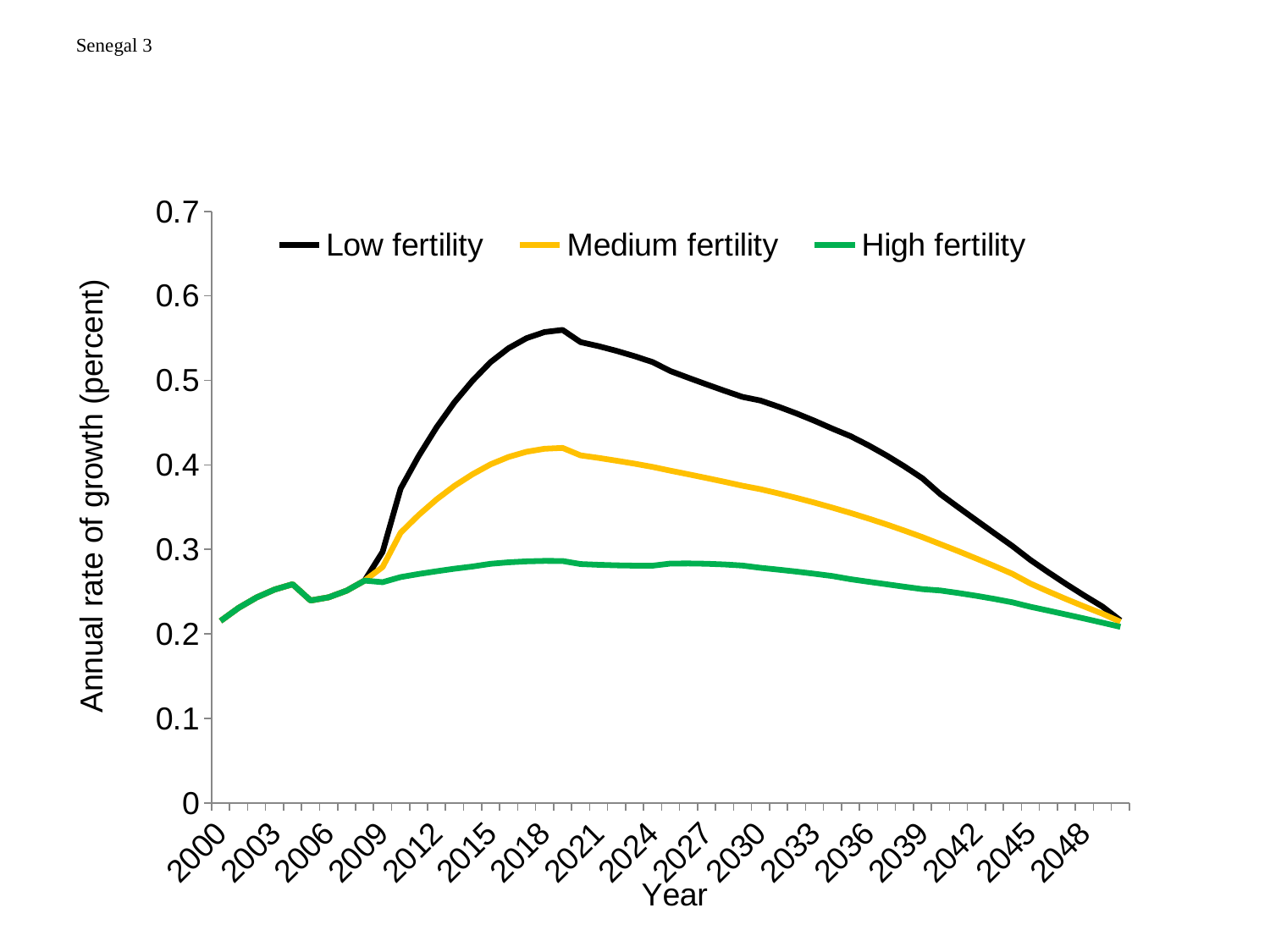
Is the value for High fertility in 2018 greater or less than 0.3? less Is the value for Low fertility in 2018 greater or less than 0.5? greater What is the title of the vertical axis? Annual rate of growth (percent) Is the value for Low fertility in 2048 greater or less than 0.3? less What kind of chart is shown on the slide? Line chart In 2036, which series has the larger value, Medium fertility or High fertility? Medium fertility In 2024, which series has the larger value, Low fertility or Medium fertility? Low fertility How many series does the legend list? 3 Which series reaches the highest annual rate of growth on the chart? Low fertility What colour is the High fertility line in the legend? Green Does the Low fertility line rise or fall between 2021 and 2048? fall